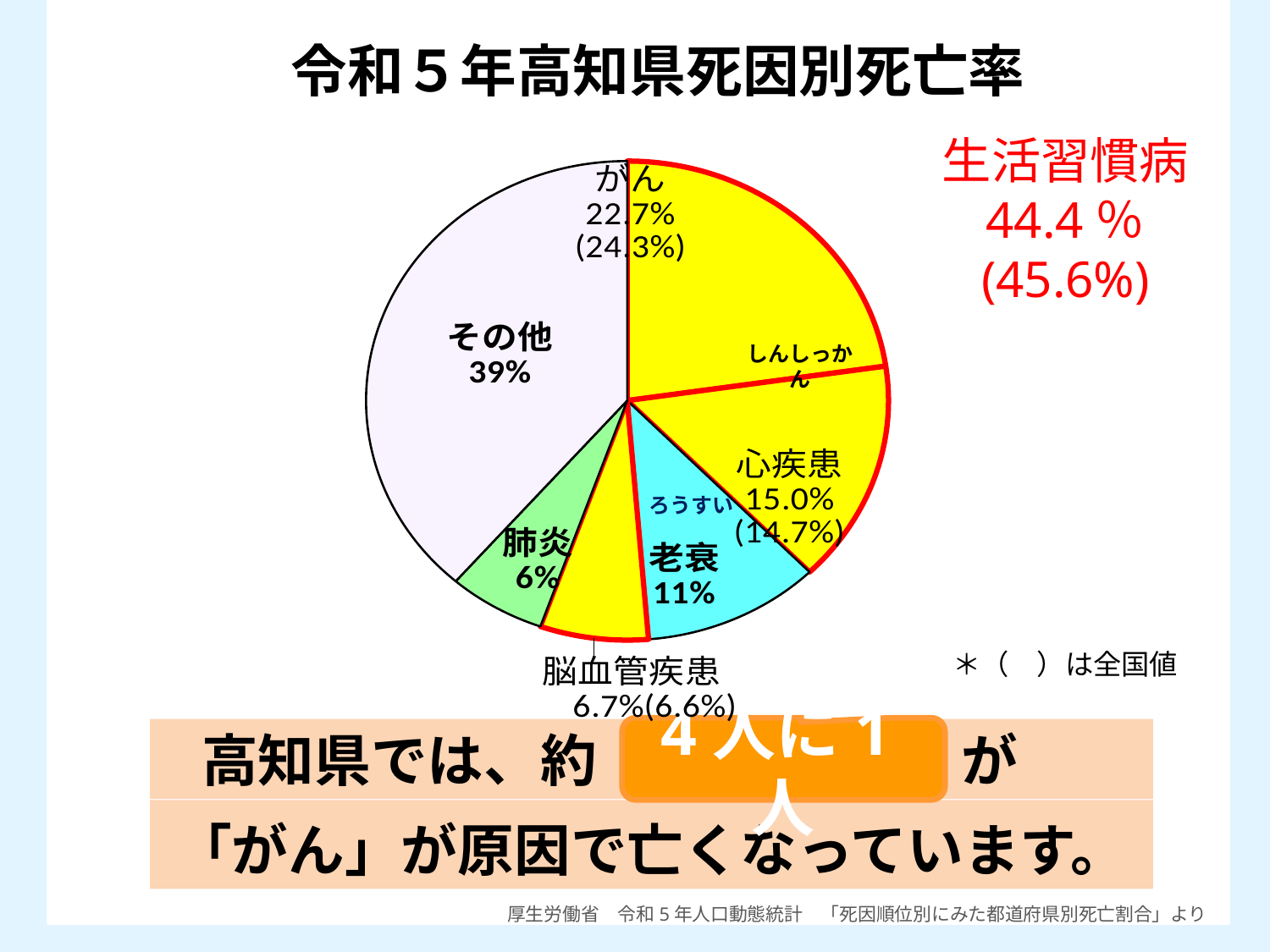
What is the value shown for 老衰? 11% Which slice of the pie chart is the smallest? 肺炎 What is the Kochi Prefecture value shown for 脳血管疾患? 6.7% What is the Kochi Prefecture value shown for がん (cancer)? 22.7% How many slices does the pie chart have? 6 Which is larger, the value for 老衰 or the value for 肺炎? 老衰 What is the value shown for 肺炎? 6% What kind of chart is shown on the slide? pie chart What is the difference between the Kochi values for がん and 心疾患? 7.7% What is the title of the chart? 令和５年高知県死因別死亡率 Which slice of the pie chart is the largest? その他 What is the Kochi Prefecture value shown for 心疾患 (heart disease)? 15.0%